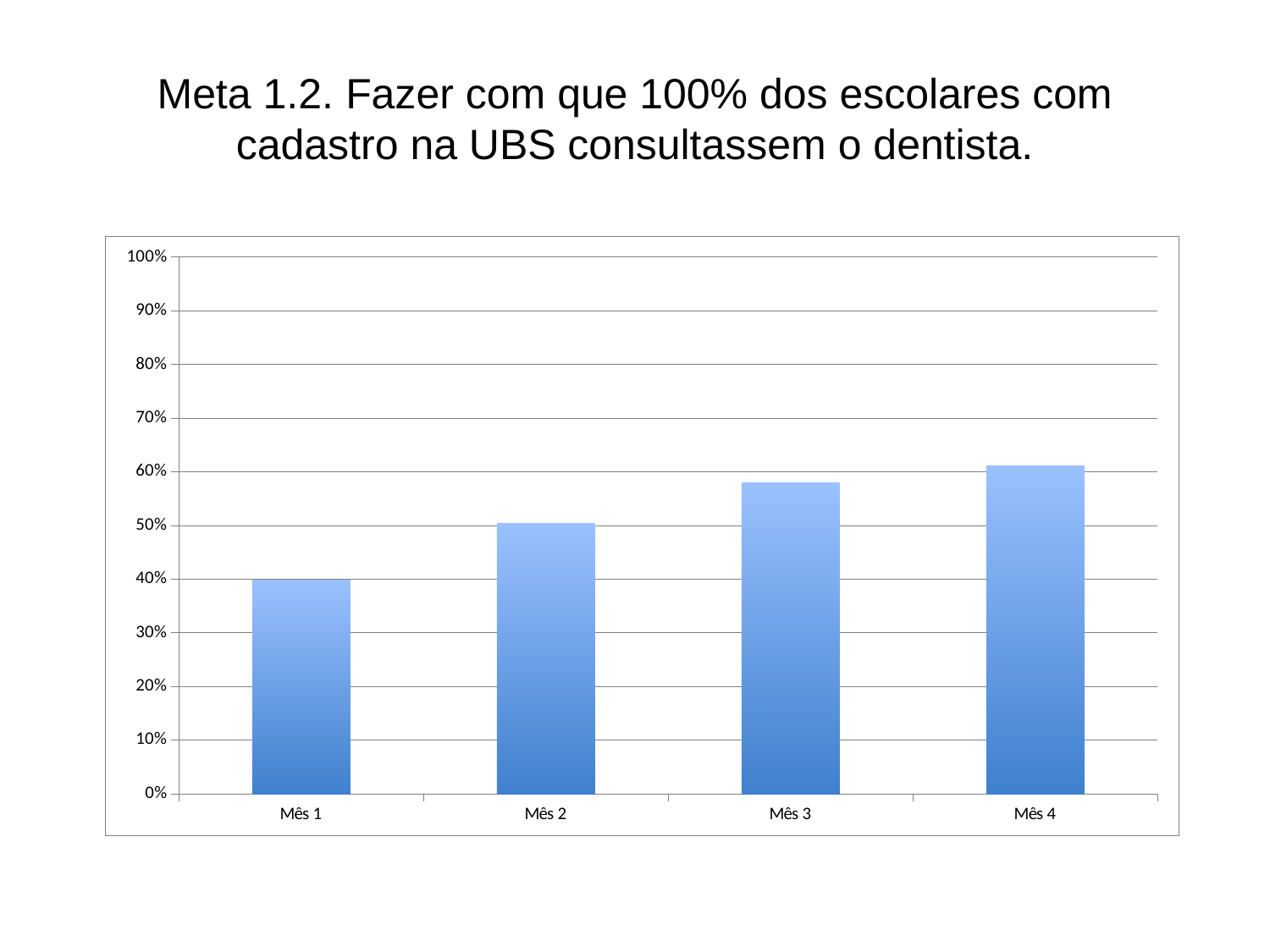
How many categories (months) are shown on the x axis of the chart? 4 Do the values rise or fall from Mês 1 to Mês 4? rise What is the highest value shown on the vertical axis of the chart? 100% Is the value for Mês 3 greater or less than 50%? greater Is the value for Mês 3 greater or less than 70%? less Which month has the lowest value? Mês 1 What kind of chart is shown on the slide? bar chart Is the value for Mês 4 greater or less than 50%? greater Which month has the highest value? Mês 4 Which is larger, the value for Mês 3 or the value for Mês 1? Mês 3